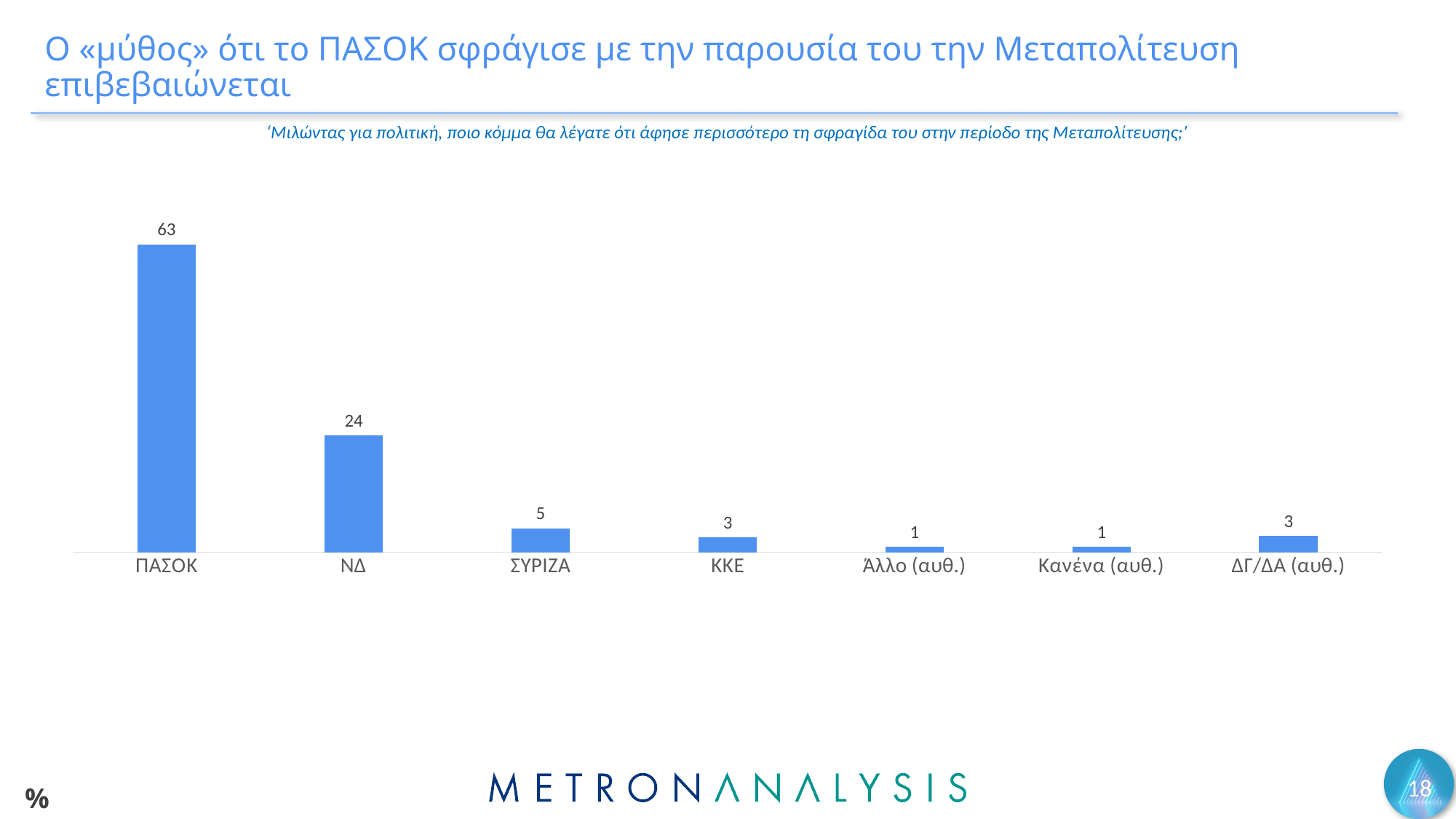
What is the value for ΚΚΕ? 3 What is the value for ΣΥΡΙΖΑ? 5 Which is larger, the value for ΣΥΡΙΖΑ or the value for ΚΚΕ? ΣΥΡΙΖΑ What is the value for Κανένα (αυθ.)? 1 What kind of chart is shown on the slide? Bar chart What is the value for ΝΔ? 24 What is the difference between the values for ΝΔ and ΣΥΡΙΖΑ? 19 What is the value for ΠΑΣΟΚ? 63 Which category has the highest value? ΠΑΣΟΚ How many categories are shown on the x axis? 7 What is the value for ΔΓ/ΔΑ (αυθ.)? 3 What is the difference between the values for ΠΑΣΟΚ and ΝΔ? 39